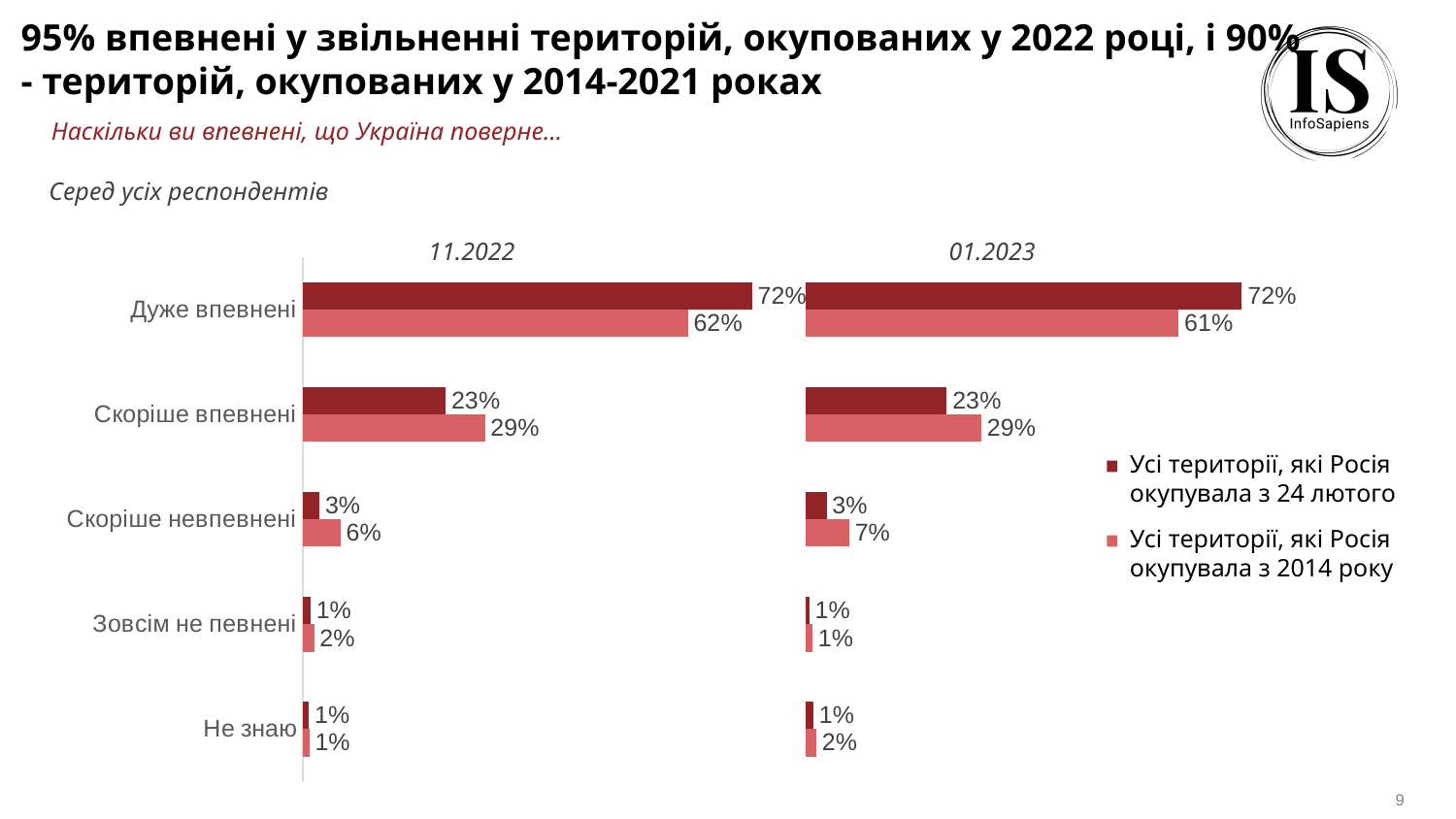
Which series is shown in the darker red colour in the legend? Усі території, які Росія окупувала з 24 лютого In the 01.2023 chart, what is the difference between the two series' values for "Дуже впевнені"? 11% In the 01.2023 chart, which series has the larger value for "Скоріше впевнені"? Усі території, які Росія окупувала з 2014 року In the 01.2023 chart, what is the value for "Дуже впевнені" for the series "Усі території, які Росія окупувала з 2014 року"? 61% In the 11.2022 chart, what is the value for "Скоріше впевнені" for the series "Усі території, які Росія окупувала з 24 лютого"? 23% What kind of chart is the 01.2023 chart? Bar chart In the 11.2022 chart, what is the value for "Дуже впевнені" for the series "Усі території, які Росія окупувала з 2014 року"? 62% In the 11.2022 chart, which category has the highest value for the series "Усі території, які Росія окупувала з 24 лютого"? Дуже впевнені In the 01.2023 chart, what is the value for "Скоріше невпевнені" for the series "Усі території, які Росія окупувала з 2014 року"? 7% How many series does the legend list? 2 How many categories are shown in the 11.2022 chart? 5 In the 11.2022 chart, what is the difference between the two series' values for "Скоріше впевнені"? 6%